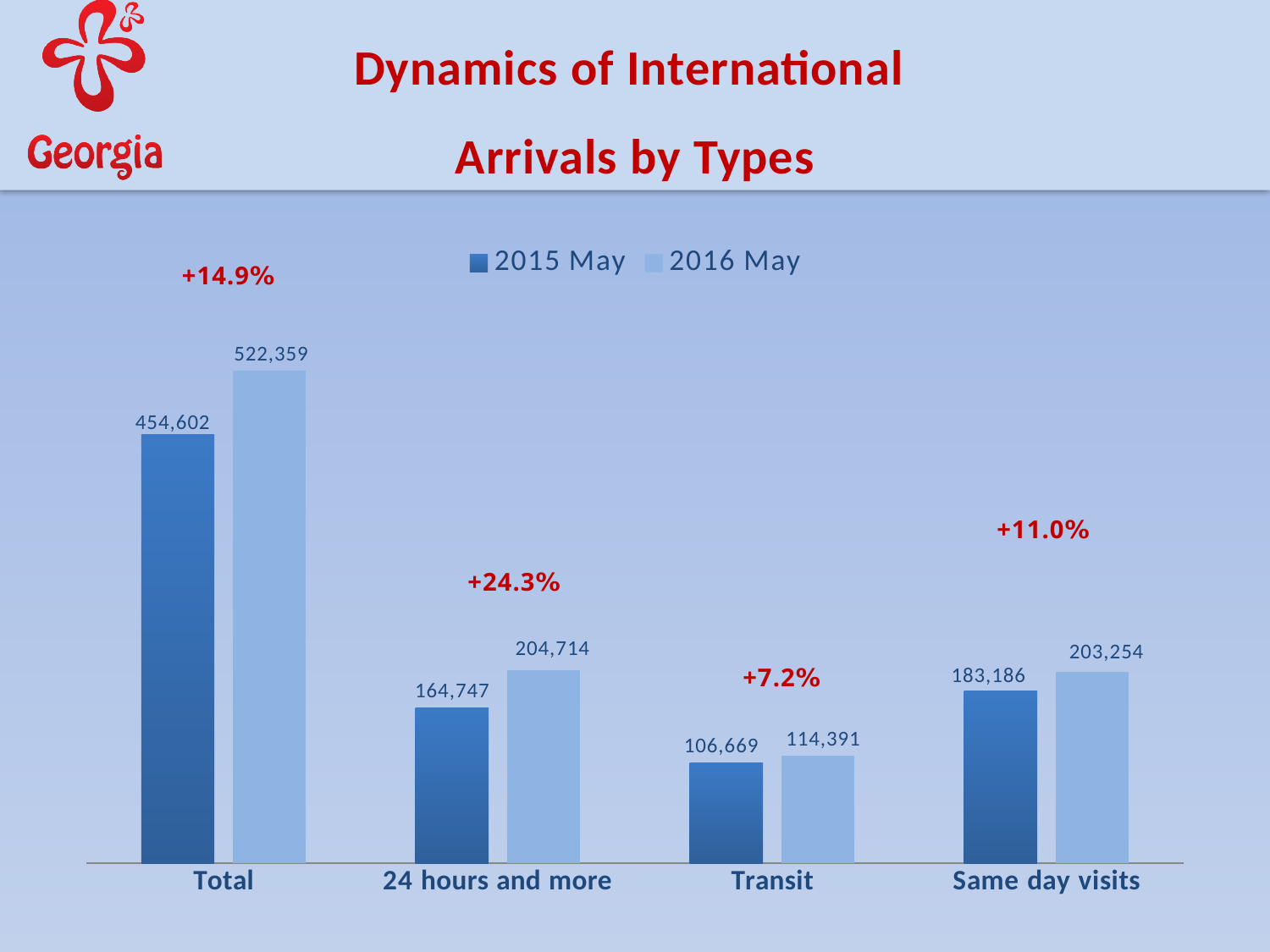
What is the value for Total in 2015 May? 454,602 What is the value for Total in 2016 May? 522,359 What is the value for Same day visits in 2015 May? 183,186 What kind of chart is shown on the slide? Bar chart Which category has the lowest value in 2015 May? Transit How many series does the legend list? 2 What is the difference between the 2016 May and 2015 May values for 24 hours and more? 39,967 What is the value for Transit in 2016 May? 114,391 How many categories are shown on the x axis? 4 Excluding Total, which category has the highest value in 2016 May? 24 hours and more Which is larger: the 2016 May value for Transit or the 2015 May value for Same day visits? 2015 May value for Same day visits What percentage change is shown above the 24 hours and more bars? +24.3%